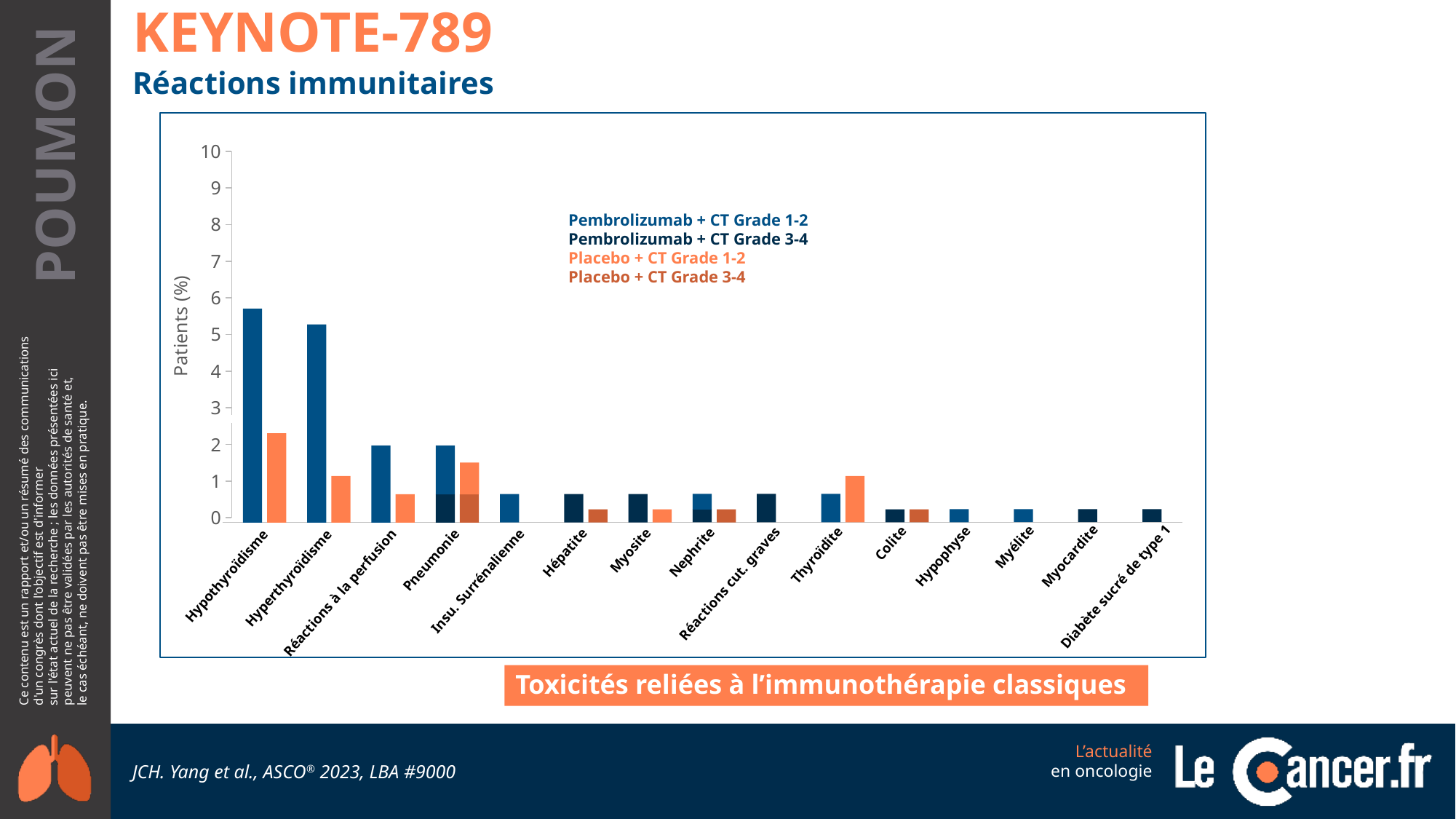
Is the value for Hypothyroïdisme in the Placebo + CT Grade 1-2 series greater or less than 3? less What is the maximum value shown on the y axis? 10 How many categories of immune reactions are shown on the x axis? 15 Is the value for Hyperthyroïdisme in the Pembrolizumab + CT Grade 1-2 series greater or less than 4? greater What kind of chart is shown on the slide? bar chart What is the label of the y axis? Patients (%) For Hypothyroïdisme, which is larger: the Pembrolizumab + CT Grade 1-2 value or the Placebo + CT Grade 1-2 value? Pembrolizumab + CT Grade 1-2 For Thyroïdite, which is larger: the Pembrolizumab + CT Grade 1-2 value or the Placebo + CT Grade 1-2 value? Placebo + CT Grade 1-2 How many series does the legend list? 4 Is the value for Hypothyroïdisme in the Pembrolizumab + CT Grade 1-2 series greater or less than 5? greater Which category has the highest value for Pembrolizumab + CT Grade 1-2? Hypothyroïdisme